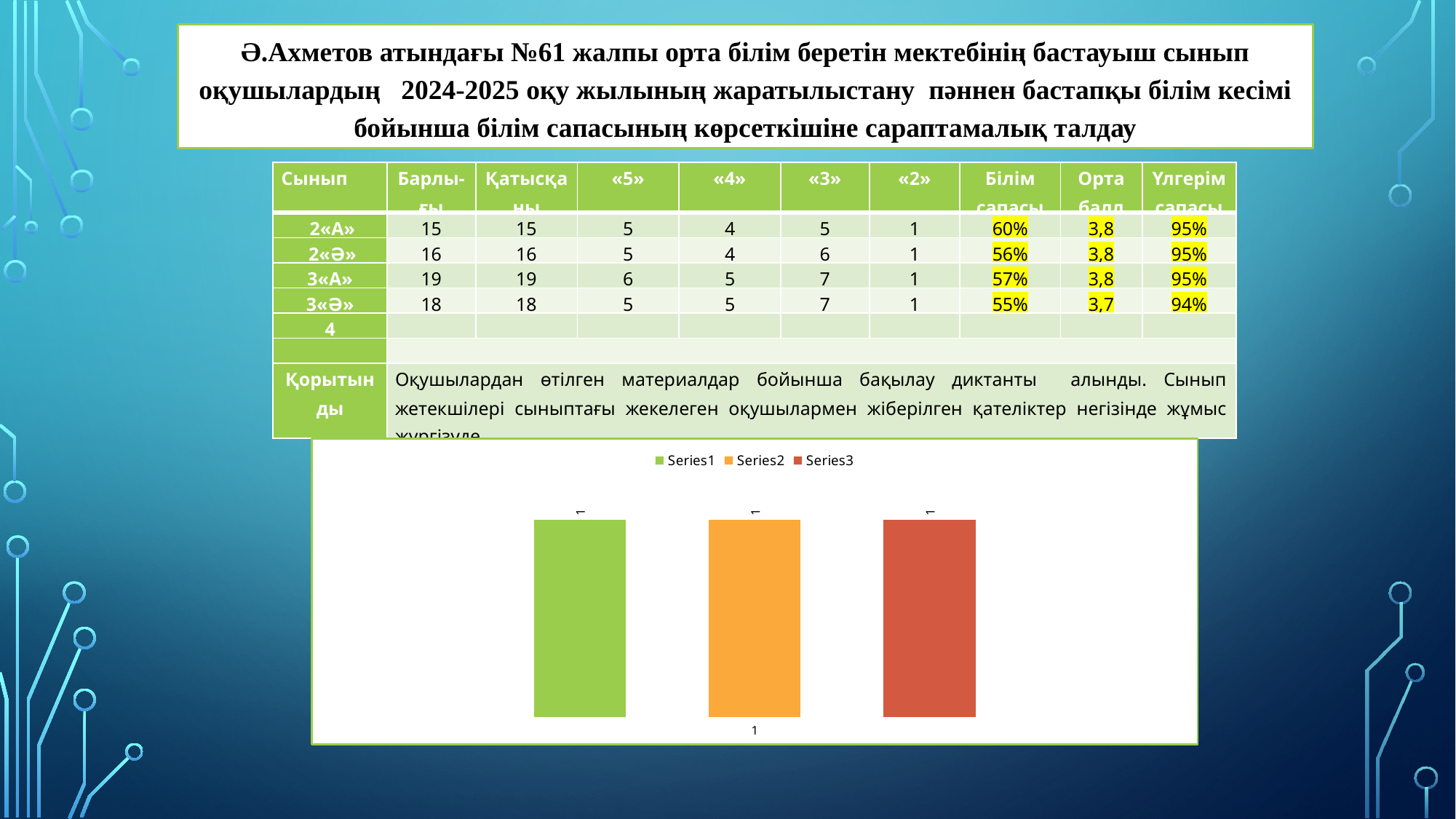
What is the value of the Series1 bar in the chart? 1 How many categories are shown on the x axis of the chart? 1 What is the value of the Series2 bar in the chart? 1 What colour is the Series2 bar in the chart? orange What is the difference between the Series1 value and the Series3 value in the chart? 0 What kind of chart is shown on the slide? bar chart What is the value of the Series3 bar in the chart? 1 What is the label of the single category on the chart's x axis? 1 How many series does the chart's legend list? 3